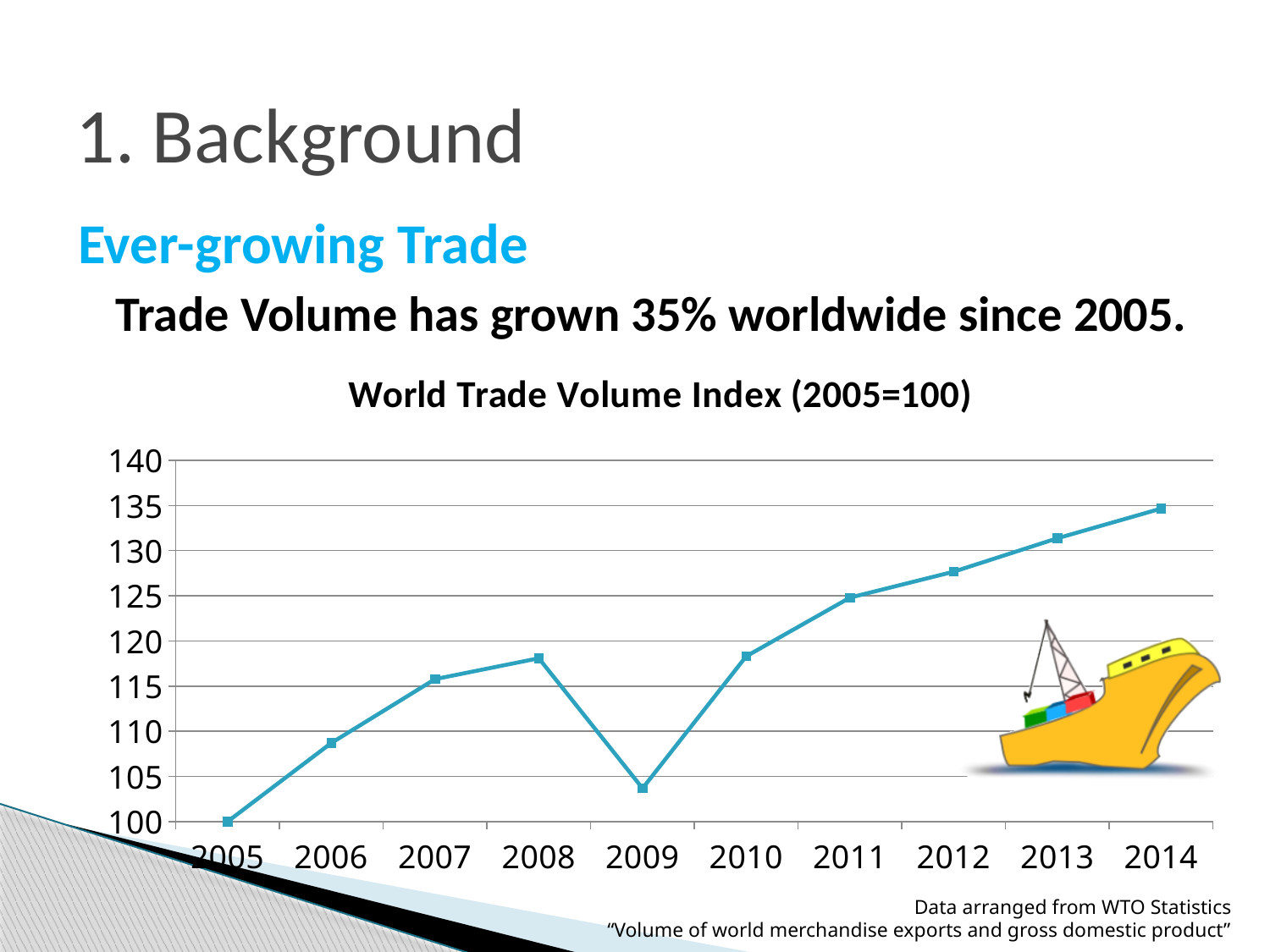
Is the value for 2011 greater or less than 120? greater Is the value for 2014 greater or less than 130? greater Which year has the lowest World Trade Volume Index value? 2005 What is the value of the World Trade Volume Index for 2005? 100 Which year has a higher index value, 2008 or 2009? 2008 What kind of chart is shown on the slide? line chart Which year has a higher index value, 2006 or 2012? 2012 Is the value for 2009 greater or less than 105? less Which year has the highest World Trade Volume Index value? 2014 Does the World Trade Volume Index rise or fall from 2009 to 2014? rise What is the title of the chart? World Trade Volume Index (2005=100) How many years are plotted on the x axis of the chart? 10